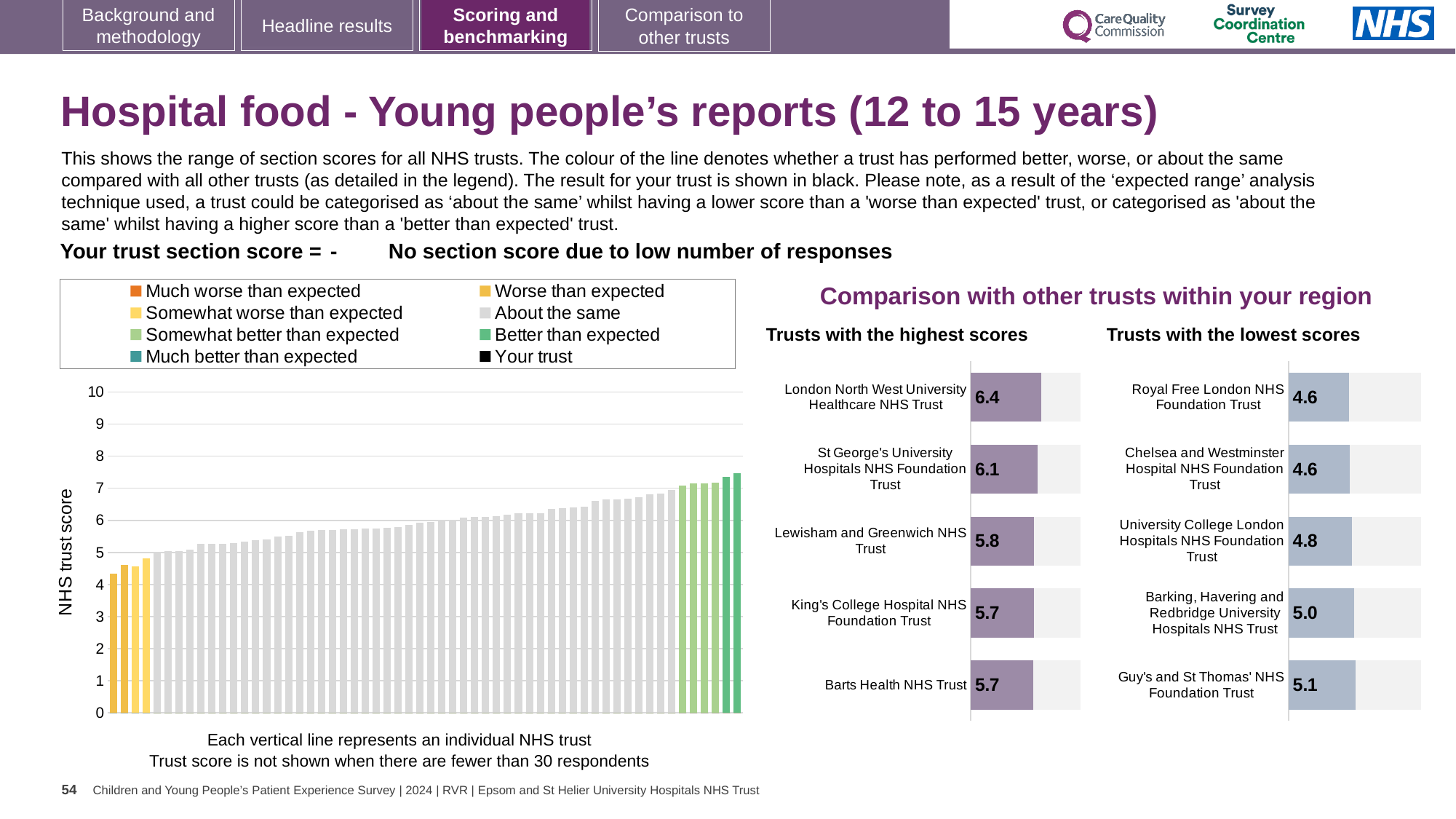
In the 'Trusts with the lowest scores' chart, what is the score for University College London Hospitals NHS Foundation Trust? 4.8 In the large chart on the left, do the NHS trust scores rise or fall from left to right? Rise How many trusts are listed in the 'Trusts with the highest scores' chart? 5 In the 'Trusts with the lowest scores' chart, how much higher is Guy's and St Thomas' NHS Foundation Trust's score than Royal Free London NHS Foundation Trust's score? 0.5 What kind of chart is the large chart on the left showing NHS trust scores? Bar chart How many entries does the legend above the large chart on the left list? 8 Which has the higher score: St George's University Hospitals NHS Foundation Trust in the highest scores chart, or Barking, Havering and Redbridge University Hospitals NHS Trust in the lowest scores chart? St George's University Hospitals NHS Foundation Trust In the 'Trusts with the highest scores' chart, what is the difference between the scores of London North West University Healthcare NHS Trust and Lewisham and Greenwich NHS Trust? 0.6 In the 'Trusts with the lowest scores' chart, which trust has the highest score shown? Guy's and St Thomas' NHS Foundation Trust In the 'Trusts with the highest scores' chart, what is the score for London North West University Healthcare NHS Trust? 6.4 In the large chart on the left, is the value of the tallest bar greater or less than 7? greater In the 'Trusts with the highest scores' chart, which trust has the highest score? London North West University Healthcare NHS Trust